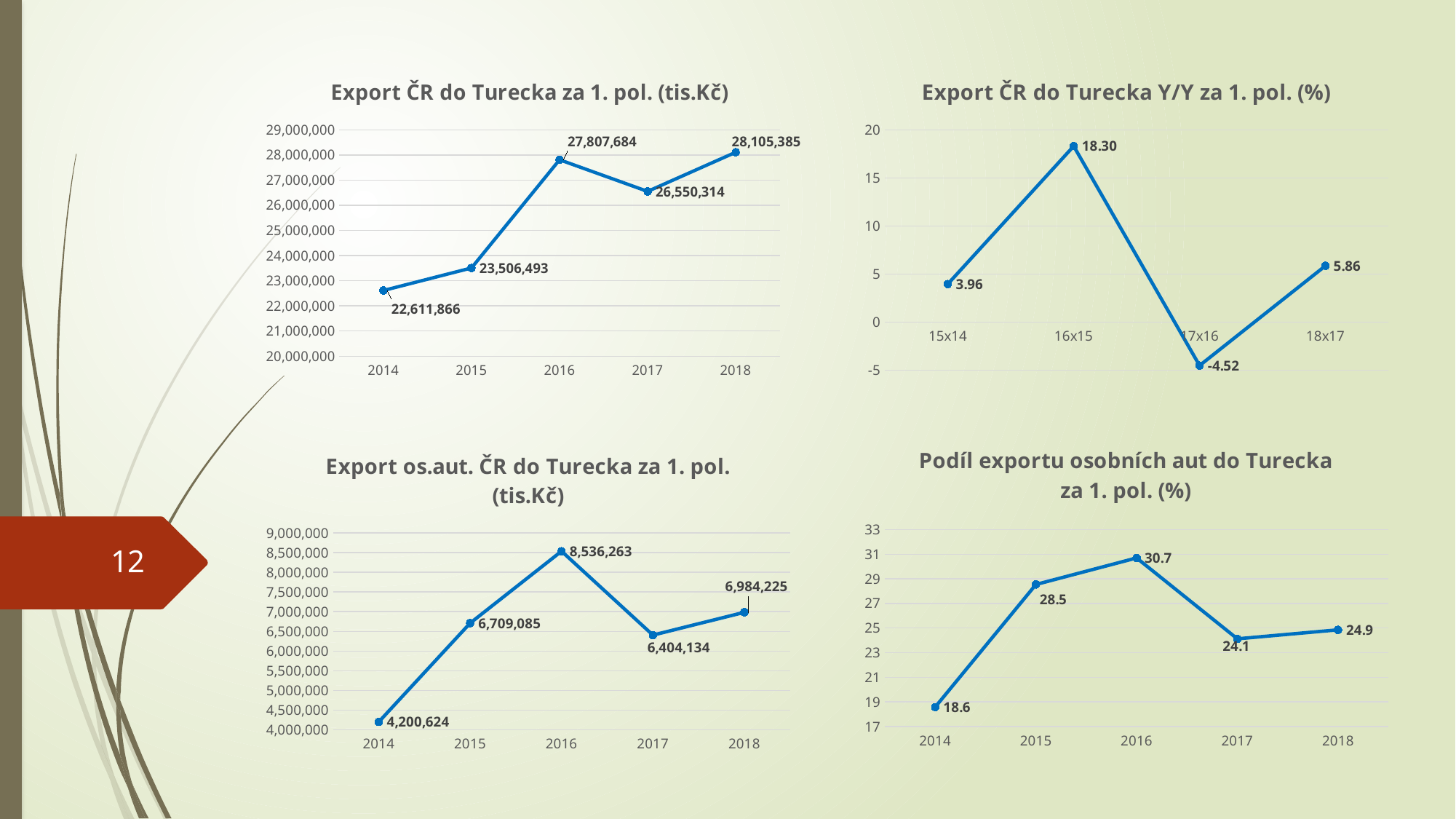
In the top-left chart 'Export ČR do Turecka za 1. pol. (tis.Kč)', what is the difference between the 2018 and 2017 values? 1,555,071 In the top-left chart 'Export ČR do Turecka za 1. pol. (tis.Kč)', what is the value for 2016? 27,807,684 In the bottom-right chart 'Podíl exportu osobních aut do Turecka za 1. pol. (%)', what is the value for 2017? 24.1 In the top-right chart 'Export ČR do Turecka Y/Y za 1. pol. (%)', which period has the highest value? 16x15 In the bottom-left chart 'Export os.aut. ČR do Turecka za 1. pol. (tis.Kč)', is the value for 2018 larger or smaller than the value for 2015? larger In the bottom-right chart 'Podíl exportu osobních aut do Turecka za 1. pol. (%)', what is the difference between the 2016 and 2014 values? 12.1 How many data points are plotted in the top-right chart 'Export ČR do Turecka Y/Y za 1. pol. (%)'? 4 In the top-right chart 'Export ČR do Turecka Y/Y za 1. pol. (%)', what is the value for 17x16? -4.52 In the bottom-left chart 'Export os.aut. ČR do Turecka za 1. pol. (tis.Kč)', what is the value for 2014? 4,200,624 In the bottom-left chart 'Export os.aut. ČR do Turecka za 1. pol. (tis.Kč)', which year has the lowest value? 2014 What type of chart is the bottom-right chart 'Podíl exportu osobních aut do Turecka za 1. pol. (%)'? line chart In the top-left chart 'Export ČR do Turecka za 1. pol. (tis.Kč)', which year has the highest value? 2018